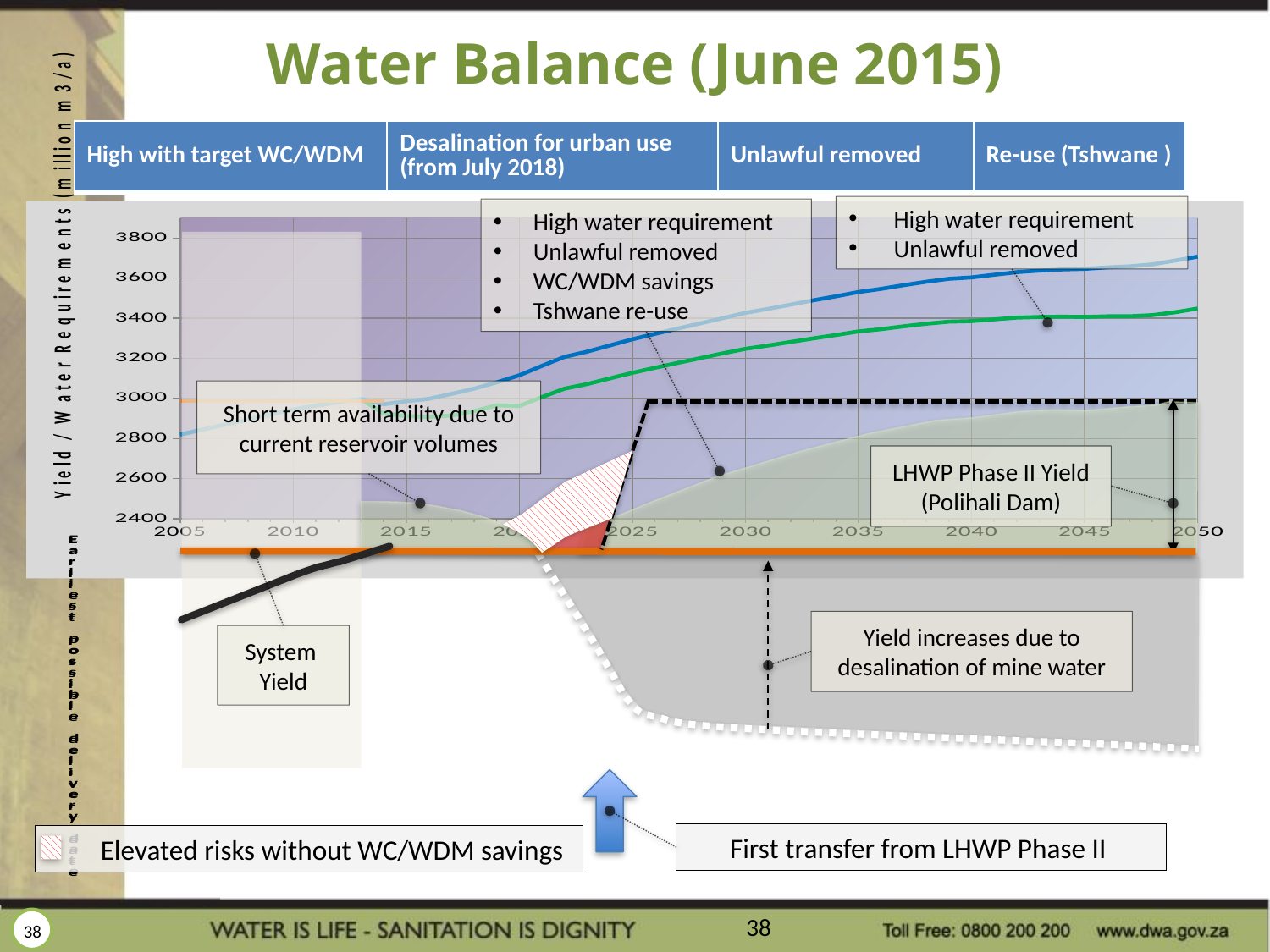
What is the title of the slide containing the chart? Water Balance (June 2015) What is the last year shown on the x axis of the chart? 2050 What is the highest value shown on the y axis of the chart? 3800 Is the value of the green line in 2025 greater or less than 3000? greater What is the first year shown on the x axis of the chart? 2005 What is the lowest value shown on the y axis of the chart? 2400 How many year ticks are labelled on the x axis of the chart? 10 Is the value of the light blue (top) line in 2050 greater or less than 3600? greater Do the water requirement lines rise or fall from 2005 to 2050? rise What kind of chart is shown on the slide? line chart What is the label of the y axis of the chart? Yield / Water Requirements (million m3/a) How many entries does the legend above the chart list? 4